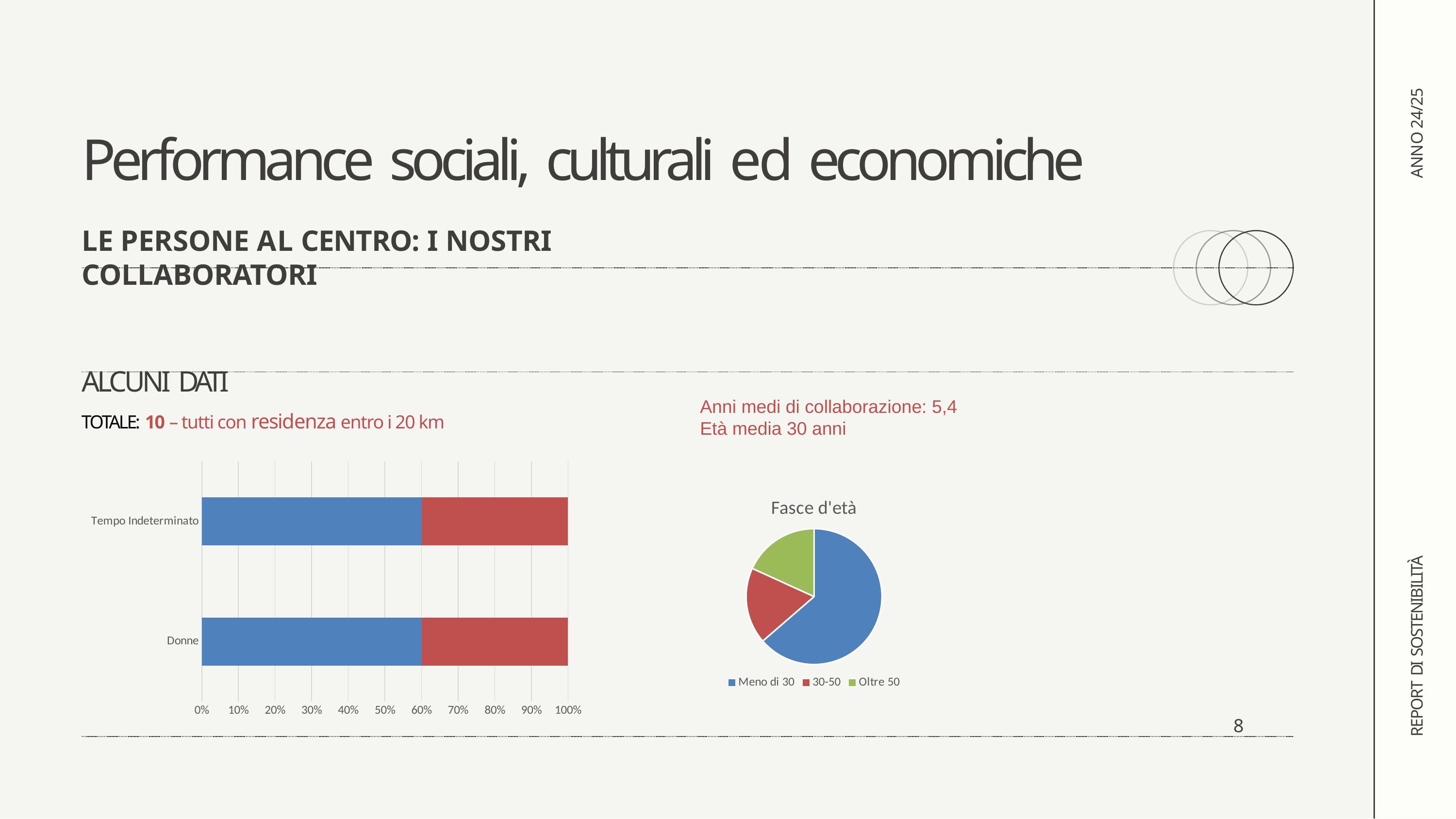
How many entries does the legend of the pie chart Fasce d'età list? 3 In the bar chart on the left of the slide, what are the two category labels on the vertical axis? Tempo Indeterminato and Donne In the pie chart Fasce d'età, which age group has the largest slice? Meno di 30 In the bar chart on the left of the slide, at which axis tick does the blue segment of the Tempo Indeterminato bar end? 60% How many categories does the bar chart on the left of the slide show? 2 In the bar chart on the left of the slide, at which axis tick does the full stacked bar for Tempo Indeterminato end? 100% In the pie chart Fasce d'età, which is larger, the slice for Meno di 30 or the slice for Oltre 50? Meno di 30 What is the title of the pie chart on the right of the slide? Fasce d'età In the bar chart on the left of the slide, at which axis tick does the blue segment of the Donne bar end? 60% In the bar chart on the left of the slide, is the blue segment of the Donne bar greater or less than 50%? greater In the bar chart on the left of the slide, is the blue segment of the Tempo Indeterminato bar greater or less than 70%? less What kind of chart is the chart on the left of the slide, with the categories Tempo Indeterminato and Donne? bar chart